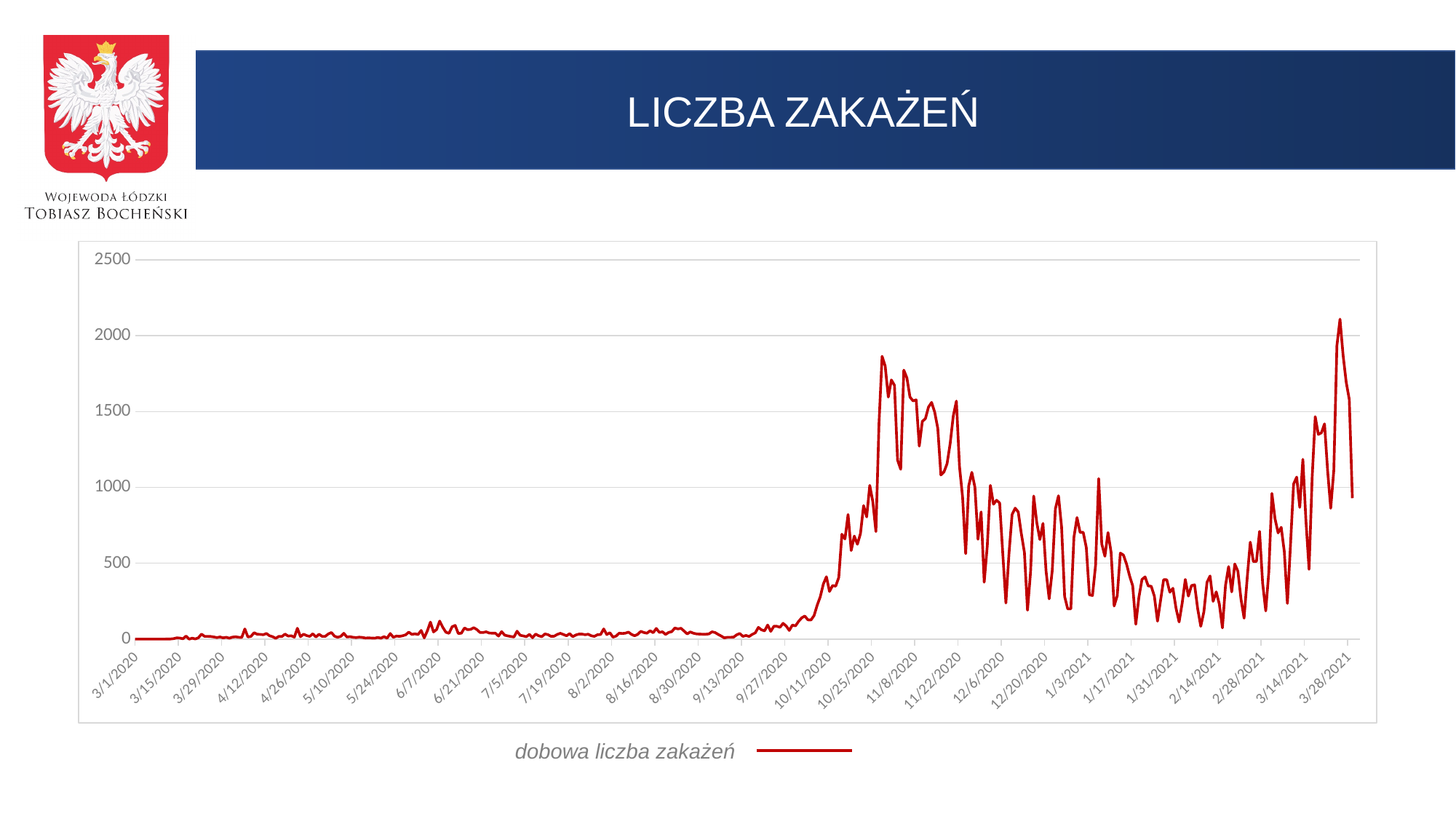
Is the value for 7/5/2020 greater or less than 500? less In which month does the line reach its highest value? March 2021 Is the value for 1/31/2021 greater or less than 1000? less What is the title of the chart? LICZBA ZAKAŻEŃ Which is higher: the peak in early November 2020 or the peak in late March 2021? the peak in late March 2021 Is the highest value reached in March 2021 greater or less than 2000? greater Do the values generally rise or fall between 1/31/2021 and 3/14/2021? rise How many series does the legend list? 1 What is the name of the series shown in the legend? dobowa liczba zakażeń Do the values generally rise or fall between 11/8/2020 and 1/17/2021? fall What kind of chart is shown on the slide? line chart